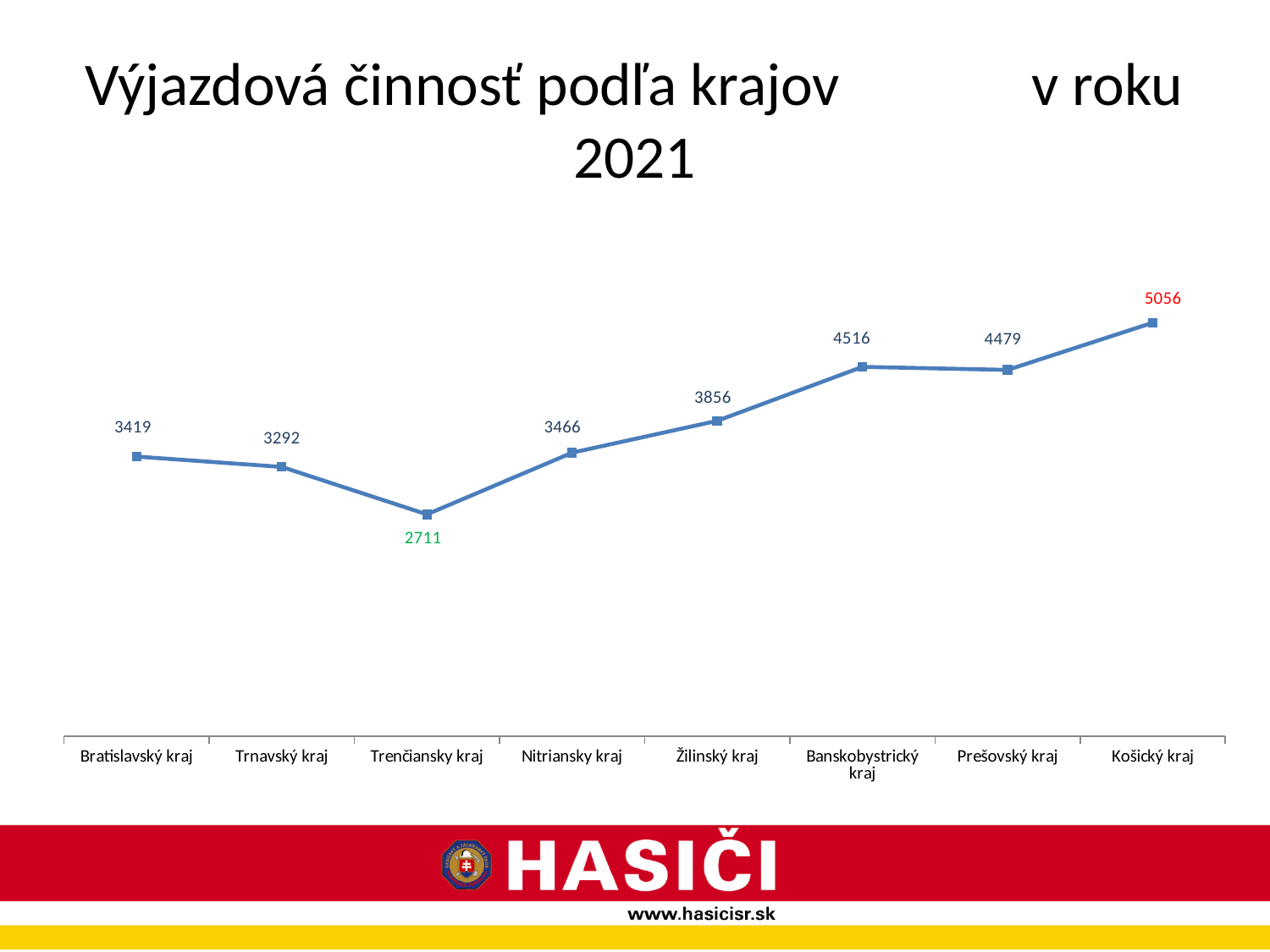
What is the value for Žilinský kraj? 3856 How many regions are plotted on the chart? 8 Which is larger, the value for Nitriansky kraj or the value for Trnavský kraj? Nitriansky kraj Which region has the highest value? Košický kraj Do the values rise or fall from Trenčiansky kraj to Banskobystrický kraj? Rise Which region has the lowest value? Trenčiansky kraj What is the value for Bratislavský kraj? 3419 What is the value for Prešovský kraj? 4479 What is the difference between the values for Košický kraj and Trenčiansky kraj? 2345 What is the difference between the values for Banskobystrický kraj and Prešovský kraj? 37 What kind of chart is shown on the slide? Line chart What is the value for Trenčiansky kraj? 2711